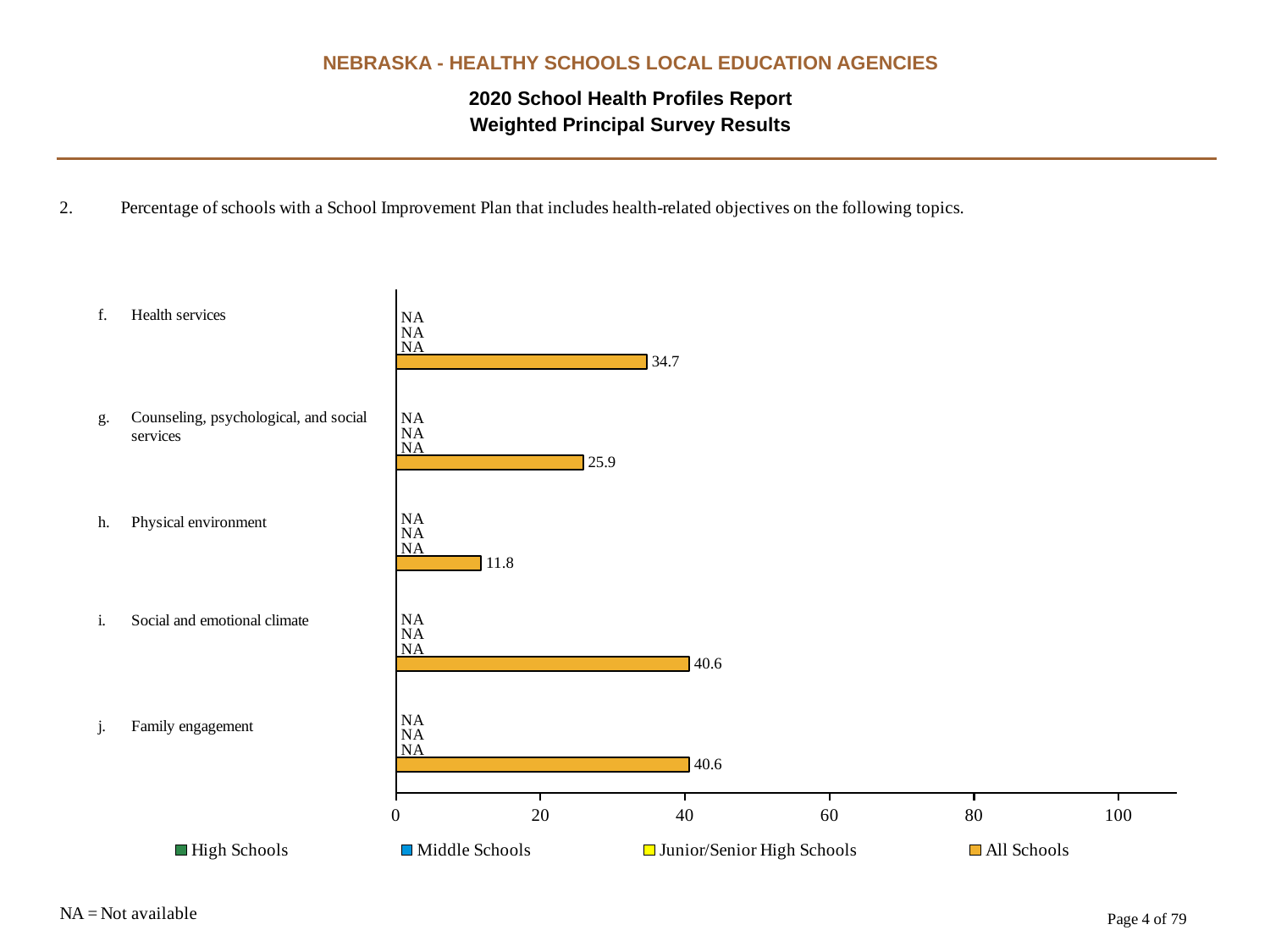
What is the All Schools value for Health services? 34.7 How many topics are listed on the chart? 5 What is the All Schools value for Family engagement? 40.6 What is the All Schools value for Counseling, psychological, and social services? 25.9 What value is shown for High Schools for Health services? NA What kind of chart is shown? bar chart Which topic has the lowest All Schools value? Physical environment Is the All Schools value for Social and emotional climate greater or less than 40? greater How many series does the legend list? 4 Which is larger for All Schools: Health services or Counseling, psychological, and social services? Health services What is the difference between the All Schools values for Health services and Physical environment? 22.9 What is the All Schools value for Physical environment? 11.8